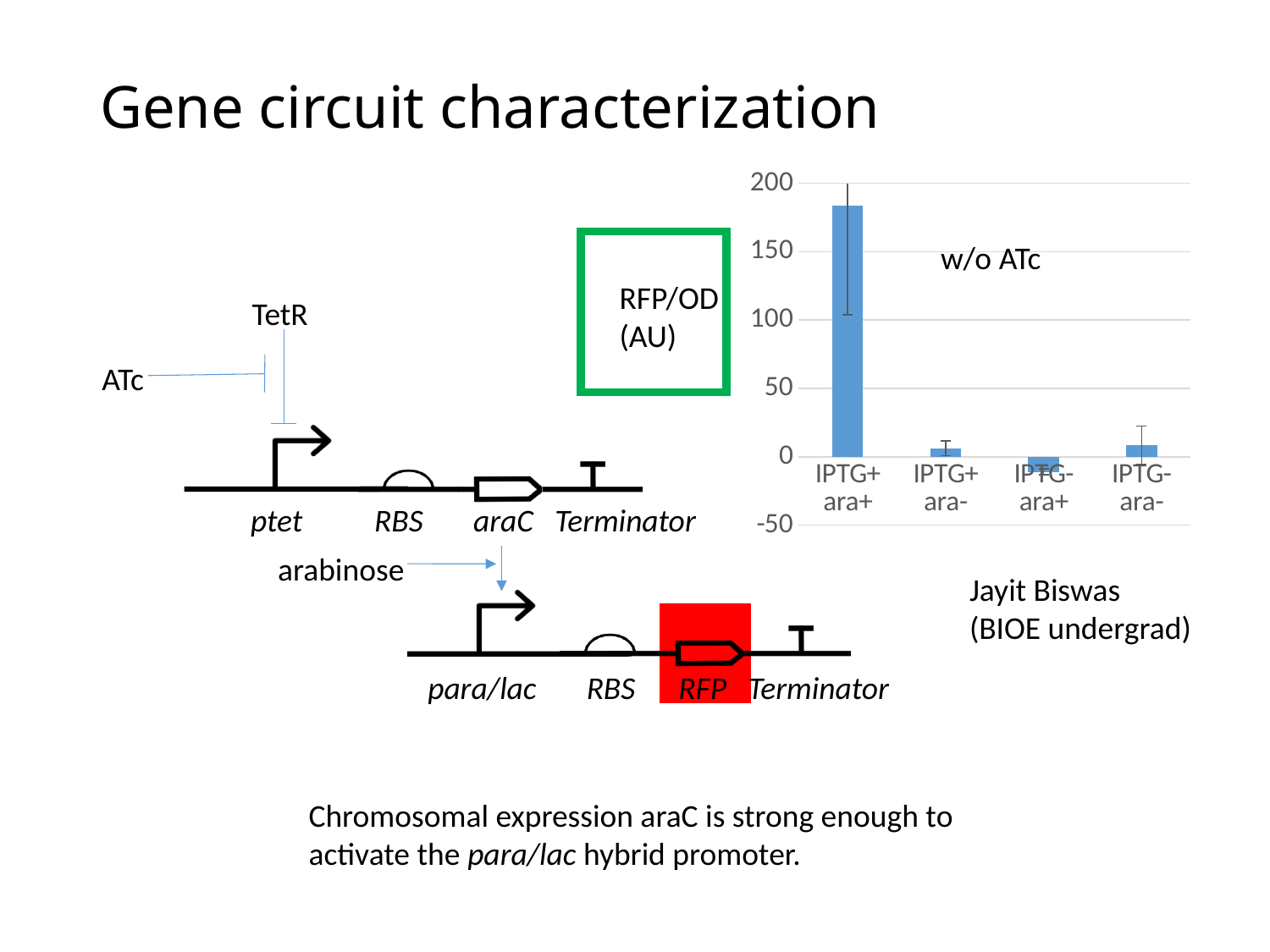
Is the value for IPTG- ara- greater or less than 50? less How many categories are plotted on the x axis of the chart? 4 What condition annotation is written inside the chart area? w/o ATc Which category has the highest RFP/OD value in the chart? IPTG+ ara+ Is the value for IPTG+ ara- greater or less than 50? less What kind of chart is shown on the slide? bar chart Which is larger, the value for IPTG+ ara- or the value for IPTG- ara+? IPTG+ ara- What is the y-axis label of the chart? RFP/OD (AU) Is the value for IPTG- ara+ greater or less than 0? less Which category has the lowest RFP/OD value in the chart? IPTG- ara+ Which is larger, the value for IPTG+ ara+ or the value for IPTG+ ara-? IPTG+ ara+